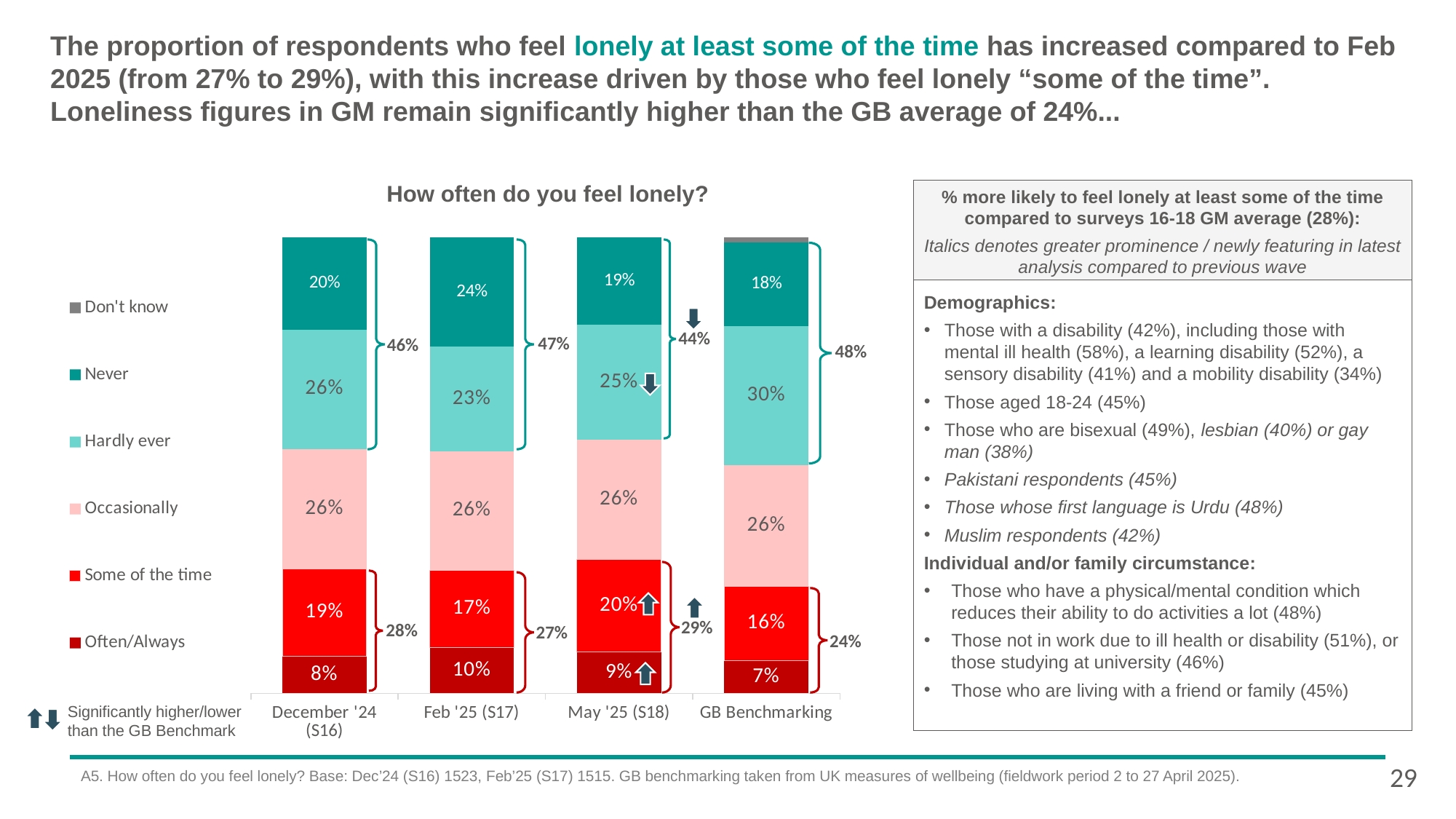
What is the value for 'Often/Always' in the GB Benchmarking bar? 7% What is the value for 'Occasionally' in the December '24 (S16) bar? 26% How many series does the chart legend list? 6 How many categories are shown along the x axis of the chart? 4 Which category has the highest value for 'Hardly ever'? GB Benchmarking What is the value for 'Some of the time' in the May '25 (S18) bar? 20% Which category has the lowest value for 'Often/Always'? GB Benchmarking What is the title of the chart? How often do you feel lonely? What is the difference between the 'Never' values for Feb '25 (S17) and May '25 (S18)? 5 percentage points What kind of chart is shown on the slide? Stacked bar chart What is the value for 'Never' in the Feb '25 (S17) bar? 24% Which is larger: the 'Some of the time' value for December '24 (S16) or for Feb '25 (S17)? December '24 (S16)